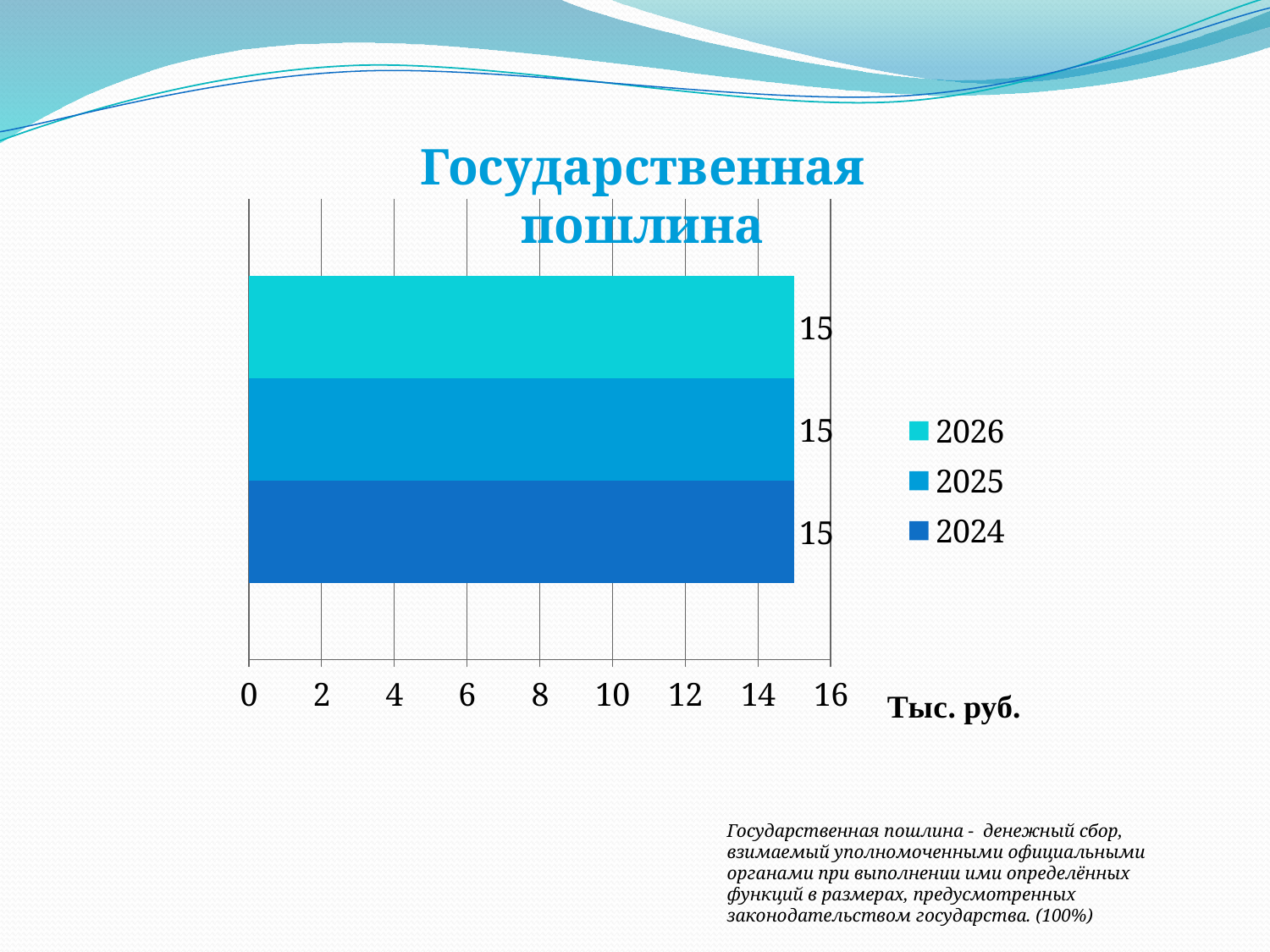
What kind of chart is shown on the slide? Bar chart Do the values change from 2024 to 2026, or stay the same? Stay the same What is the difference between the values for 2026 and 2024? 0 What unit label is shown next to the horizontal axis? Тыс. руб. Is the value for 2025 greater or less than 14? greater What is the value for 2026 in the chart? 15 How many bars are plotted in the chart? 3 How many series does the legend list? 3 What is the title of the chart? Государственная пошлина What is the value for 2025 in the chart? 15 Is the value for 2024 greater or less than 16? less What is the value for 2024 in the chart? 15